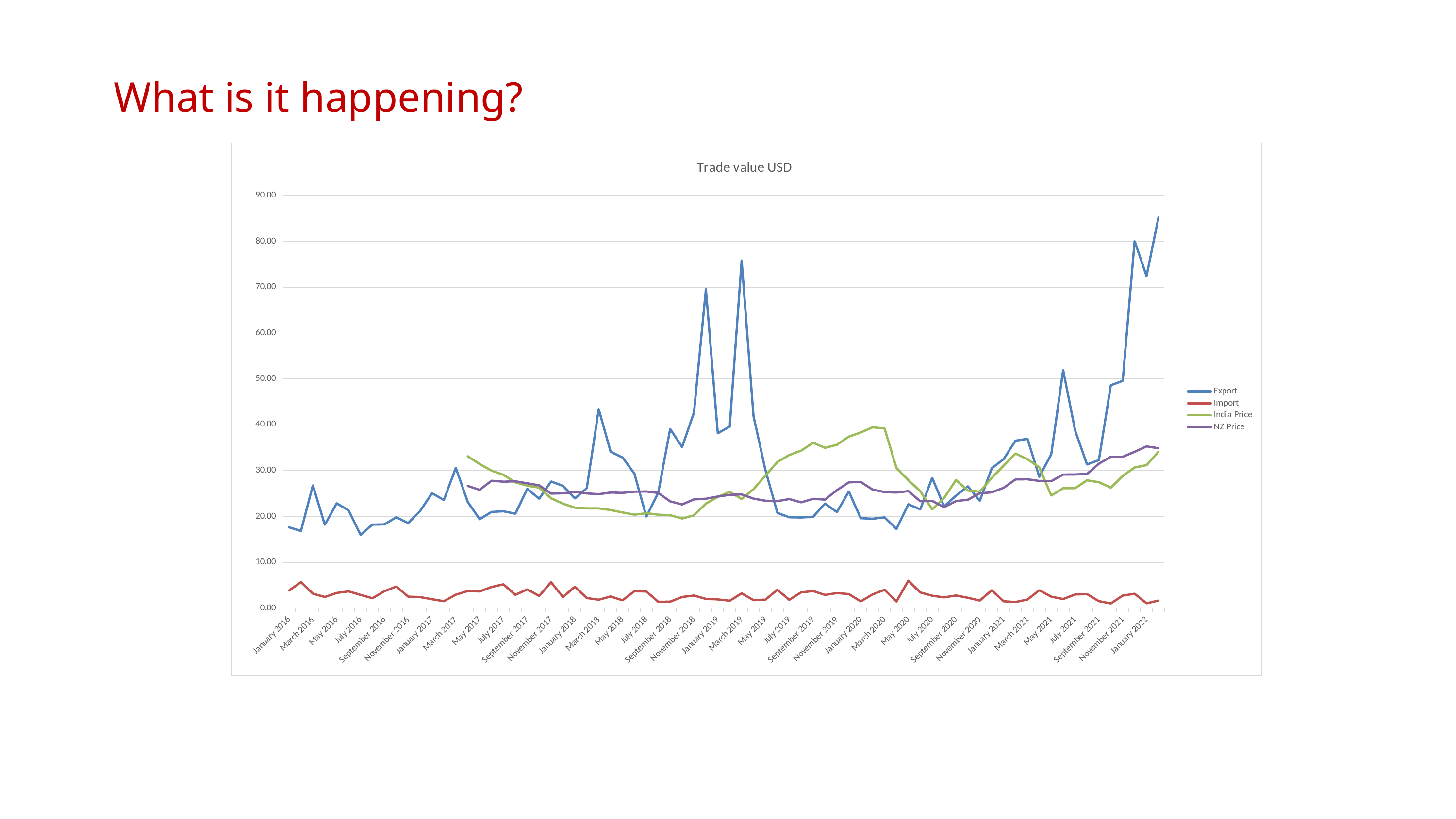
What kind of chart is shown on the slide? Line chart Does the NZ Price series generally rise or fall from 2017 to 2022? rise Is the highest Export value greater or less than 80.00? greater Which series are listed in the legend? Export, Import, India Price, NZ Price Which series has the lowest values across the whole chart? Import In March 2020, which is higher, India Price or NZ Price? India Price What is the title of the chart? Trade value USD Which series reaches the highest value on the chart? Export Is the Export value for January 2016 greater or less than 20.00? less Are the Import values greater or less than 10.00 throughout the chart? less How many series does the legend list? 4